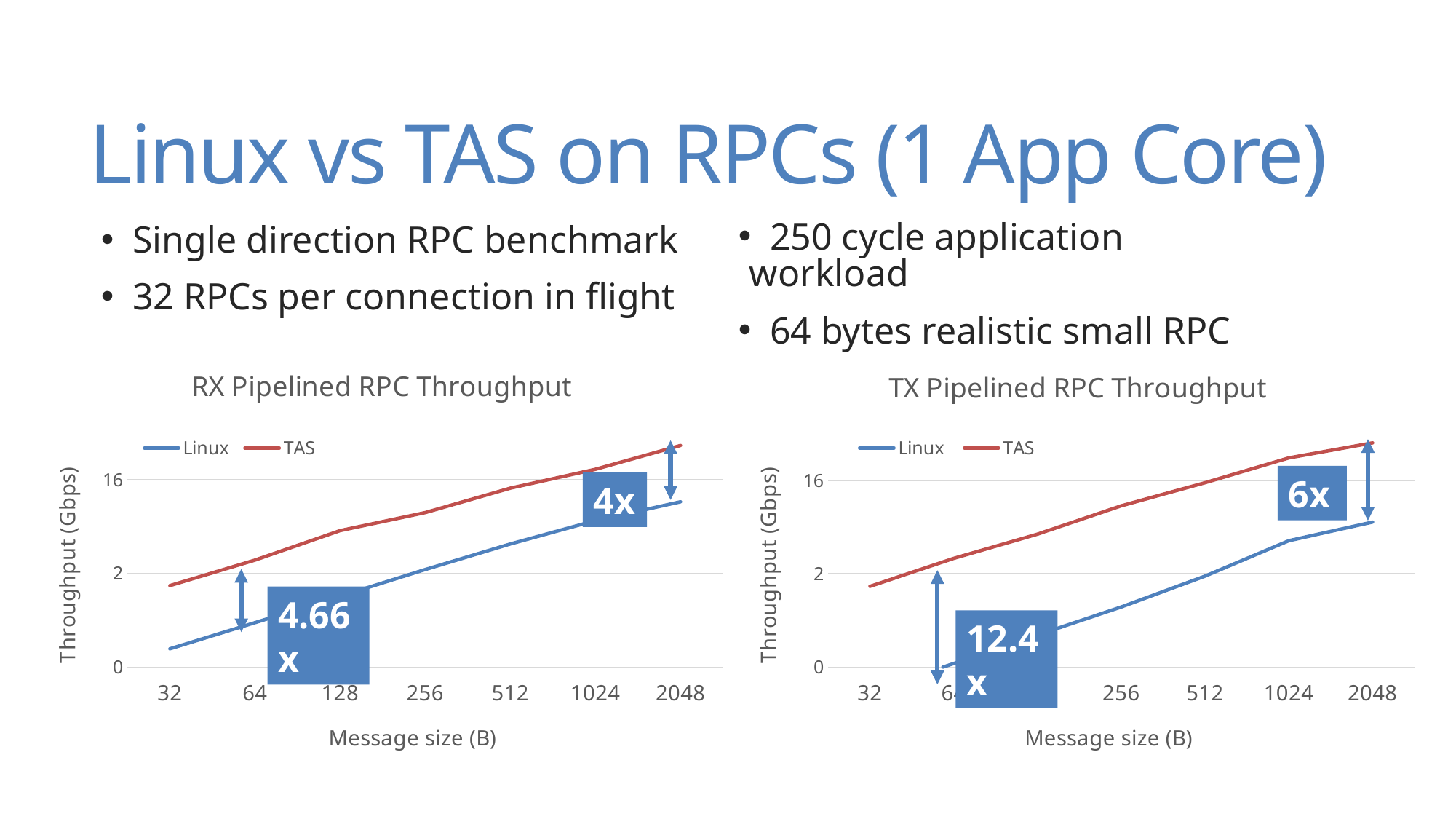
In the RX Pipelined RPC Throughput chart, which series has the higher throughput at a message size of 256 B, Linux or TAS? TAS In the RX Pipelined RPC Throughput chart, is the Linux throughput at 32 B greater or less than 2 Gbps? less In the TX Pipelined RPC Throughput chart, does the TAS throughput rise or fall as message size increases? rise In the RX Pipelined RPC Throughput chart, does the Linux throughput rise or fall as message size increases? rise How many message sizes are plotted on the x axis of the RX Pipelined RPC Throughput chart? 7 What kind of chart is the RX Pipelined RPC Throughput chart? line chart In the TX Pipelined RPC Throughput chart, is the Linux throughput at 2048 B greater or less than 16 Gbps? less What speedup factor is annotated at the small message sizes in the TX Pipelined RPC Throughput chart? 12.4x In the TX Pipelined RPC Throughput chart, which series has the lower throughput at a message size of 64 B, Linux or TAS? Linux What speedup factor is annotated at the large message sizes in the RX Pipelined RPC Throughput chart? 4x In the RX Pipelined RPC Throughput chart, is the TAS throughput at 2048 B greater or less than 16 Gbps? greater How many series does the legend of the TX Pipelined RPC Throughput chart list? 2